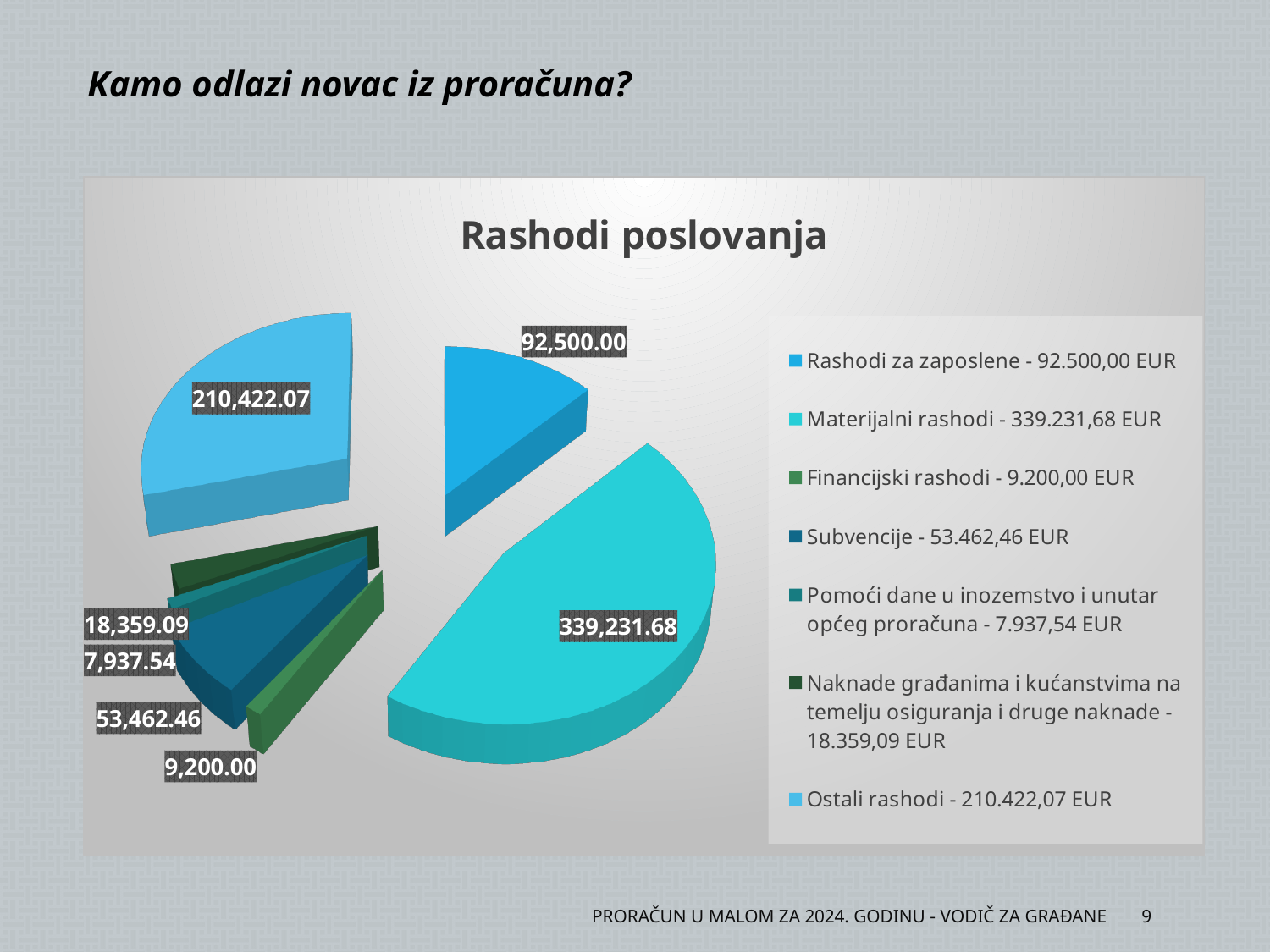
What is the difference between the values for Naknade građanima i kućanstvima and Pomoći dane u inozemstvo i unutar općeg proračuna? 10,421.55 What is the title of the chart? Rashodi poslovanja Which category has the largest slice of the pie? Materijalni rashodi What is the value shown for Subvencije? 53,462.46 How many slices does the pie chart have? 7 What type of chart is shown on the slide? Pie chart What is the value shown for Materijalni rashodi? 339,231.68 What is the difference between the values for Materijalni rashodi and Rashodi za zaposlene? 246,731.68 How many entries does the legend list? 7 Which category has the smallest slice of the pie? Pomoći dane u inozemstvo i unutar općeg proračuna What is the value shown for Financijski rashodi? 9,200.00 Which is larger, Ostali rashodi or Rashodi za zaposlene? Ostali rashodi